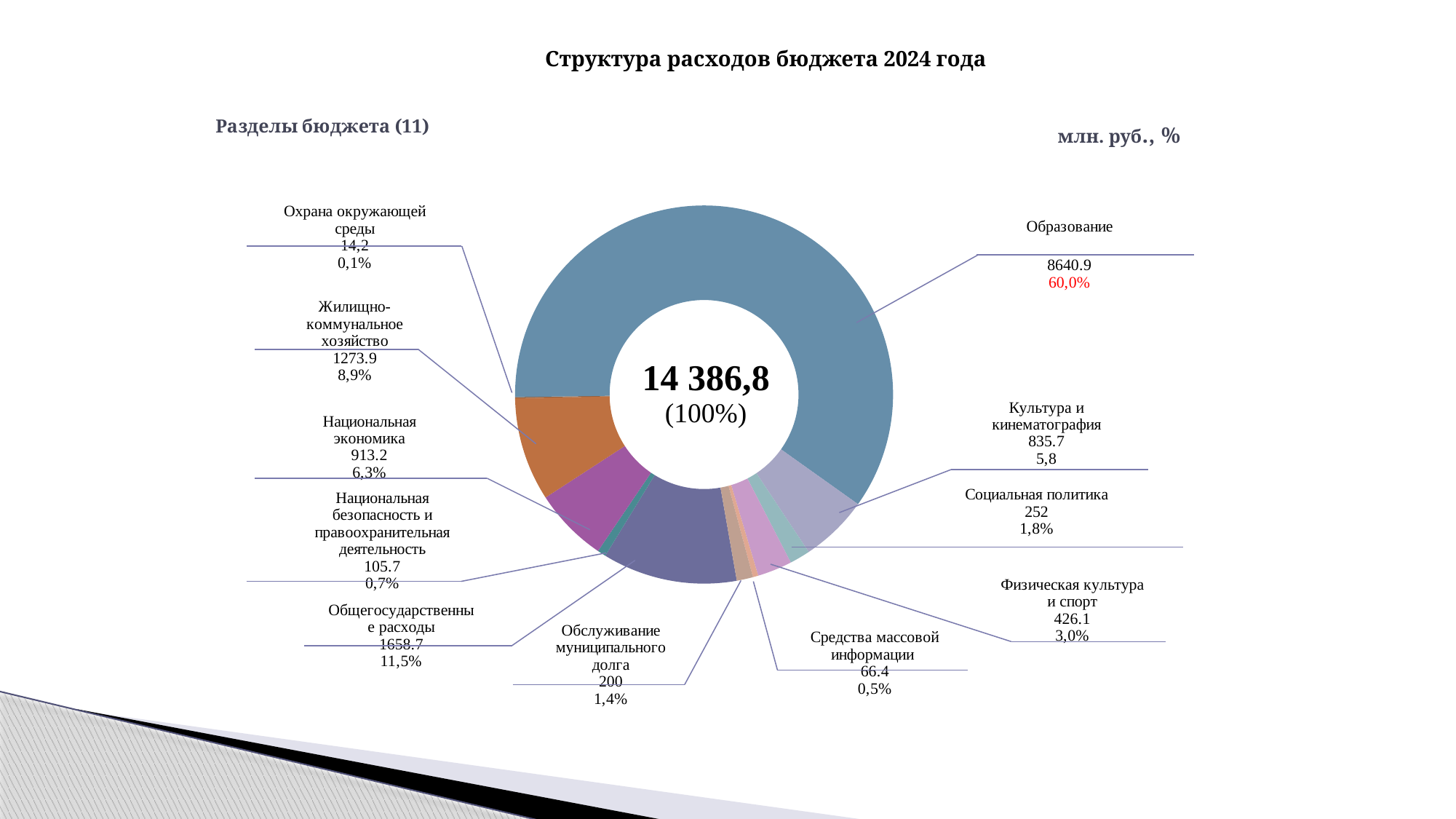
What is the total value shown in the centre of the chart? 14 386,8 What is the value for Жилищно-коммунальное хозяйство? 1273.9 What is the value for Обслуживание муниципального долга? 200 What share of the budget does Образование account for? 60,0% What is the difference between the values for Общегосударственные расходы and Жилищно-коммунальное хозяйство? 384.8 Which budget section has the smallest value? Охрана окружающей среды What kind of chart is shown on the slide? Doughnut (pie) chart How many budget sections are shown in the chart? 11 Which is larger, Национальная экономика or Культура и кинематография? Национальная экономика Which budget section has the largest value? Образование What is the value for Образование in the chart? 8640.9 What share of the budget does Общегосударственные расходы account for? 11,5%